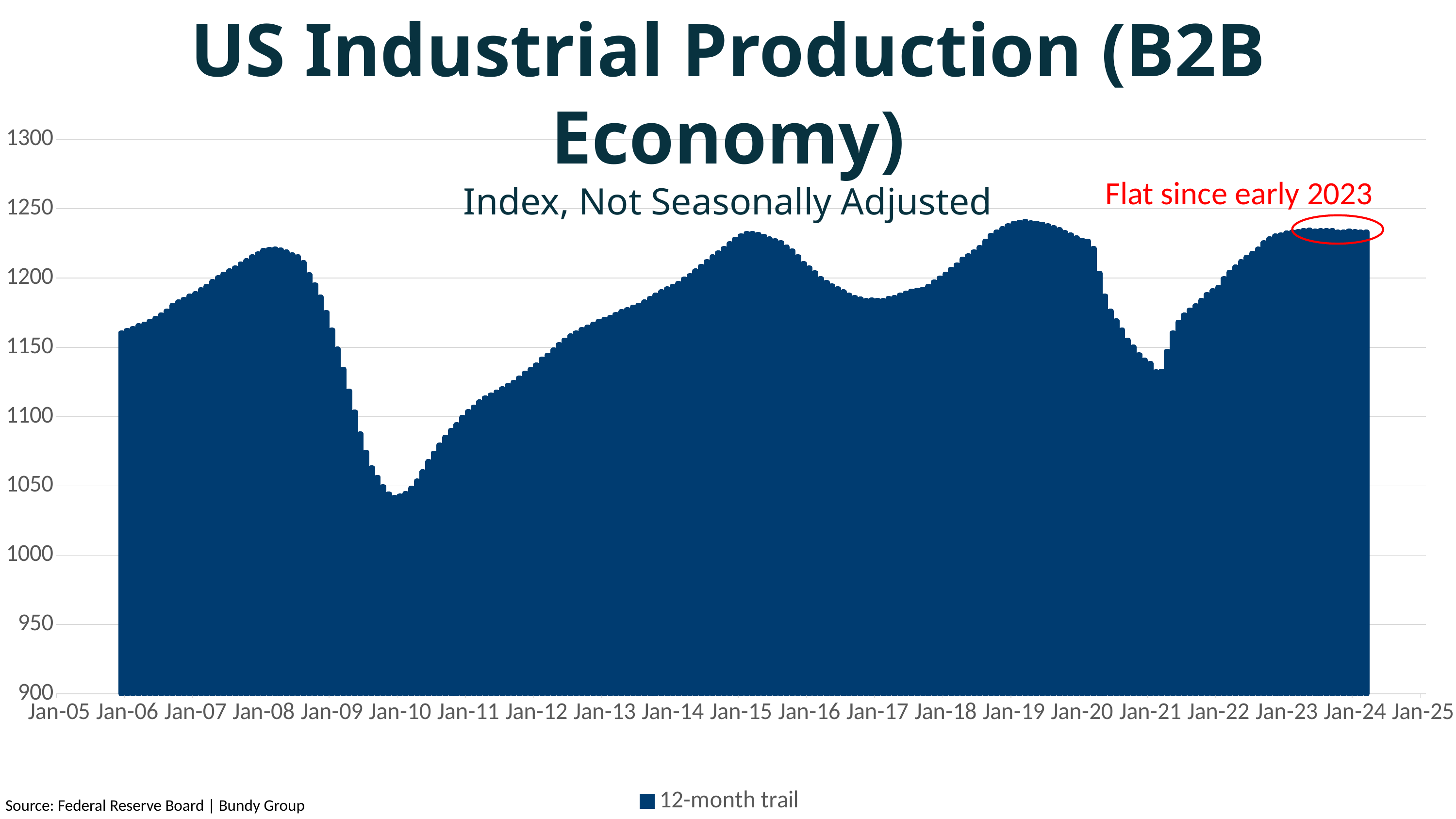
Is the value at Jan-08 greater or less than 1200? greater Do the values rise or fall between Jan-10 and Jan-15? rise Is the value at Jan-21 greater or less than 1150? less Is the value at Jan-24 greater or less than 1200? greater How many series does the legend list? 1 What is the name of the series shown in the legend? 12-month trail What does the red annotation on the chart say? Flat since early 2023 Do the values rise or fall between Jan-09 and Jan-10? fall